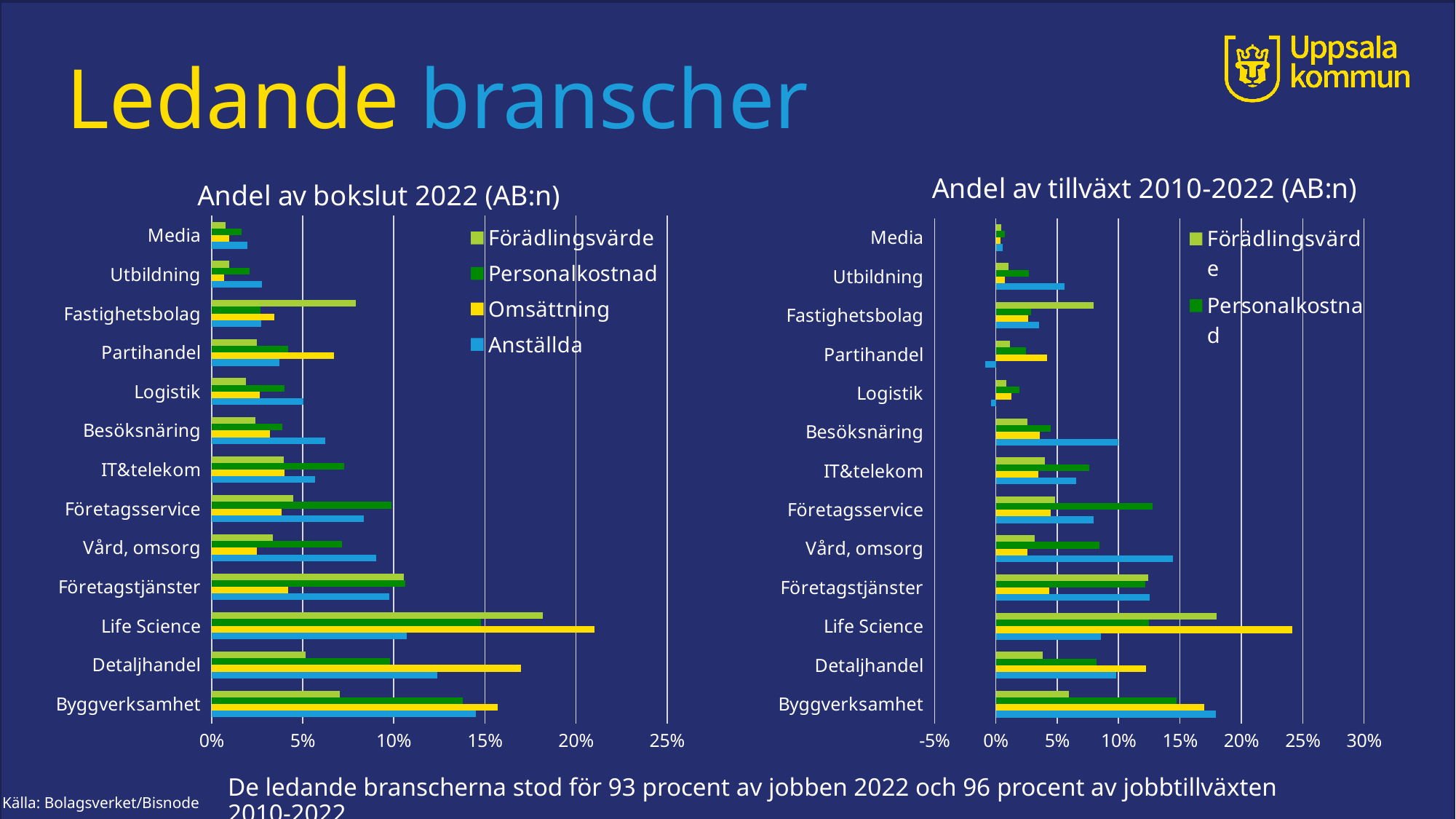
In the 'Andel av tillväxt 2010-2022 (AB:n)' chart, which category has the highest Omsättning value? Life Science In the 'Andel av tillväxt 2010-2022 (AB:n)' chart, which is larger, the Förädlingsvärde value for Fastighetsbolag or for Partihandel? Fastighetsbolag How many series does the legend of the 'Andel av bokslut 2022 (AB:n)' chart list? 4 How many categories (industries) are shown on the 'Andel av bokslut 2022 (AB:n)' chart? 13 In the 'Andel av bokslut 2022 (AB:n)' chart, is the Omsättning value for Life Science greater or less than 20%? greater In the 'Andel av tillväxt 2010-2022 (AB:n)' chart, is the Omsättning value for Life Science greater or less than 20%? greater What is the title of the chart on the right side of the slide? Andel av tillväxt 2010-2022 (AB:n) What kind of chart is the 'Andel av bokslut 2022 (AB:n)' chart? Bar chart In the 'Andel av bokslut 2022 (AB:n)' chart, is the Anställda value for Media greater or less than 5%? less In the 'Andel av bokslut 2022 (AB:n)' chart, which is larger, the Förädlingsvärde value for Byggverksamhet or for Detaljhandel? Byggverksamhet In the 'Andel av bokslut 2022 (AB:n)' chart, which category has the highest Omsättning value? Life Science